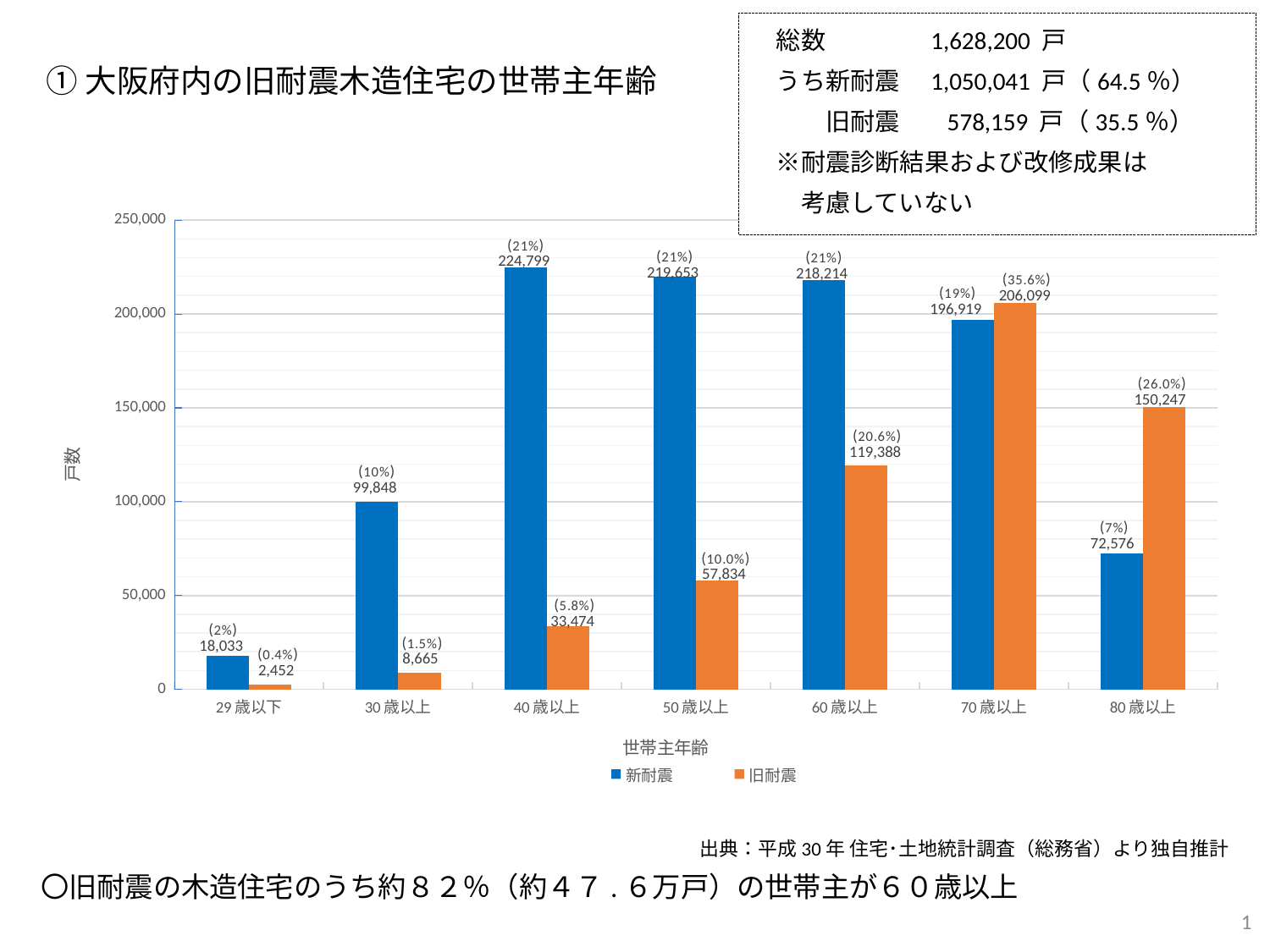
What is the label of the y axis? 戸数 Which age category has the highest 旧耐震 value? 70歳以上 What is the value of 新耐震 for the 40歳以上 category? 224,799 Is the 旧耐震 value for 50歳以上 greater or less than 100,000? less How many series does the legend list? 2 What is the difference between the 新耐震 and 旧耐震 values for 60歳以上? 98,826 What type of chart is shown on the slide? bar chart What is the value of 旧耐震 for the 70歳以上 category? 206,099 How many age categories are shown on the x axis? 7 What percentage is shown above the 旧耐震 bar for 80歳以上? 26.0% Which age category has the lowest 新耐震 value? 29歳以下 For the 80歳以上 category, which series has the larger value, 新耐震 or 旧耐震? 旧耐震